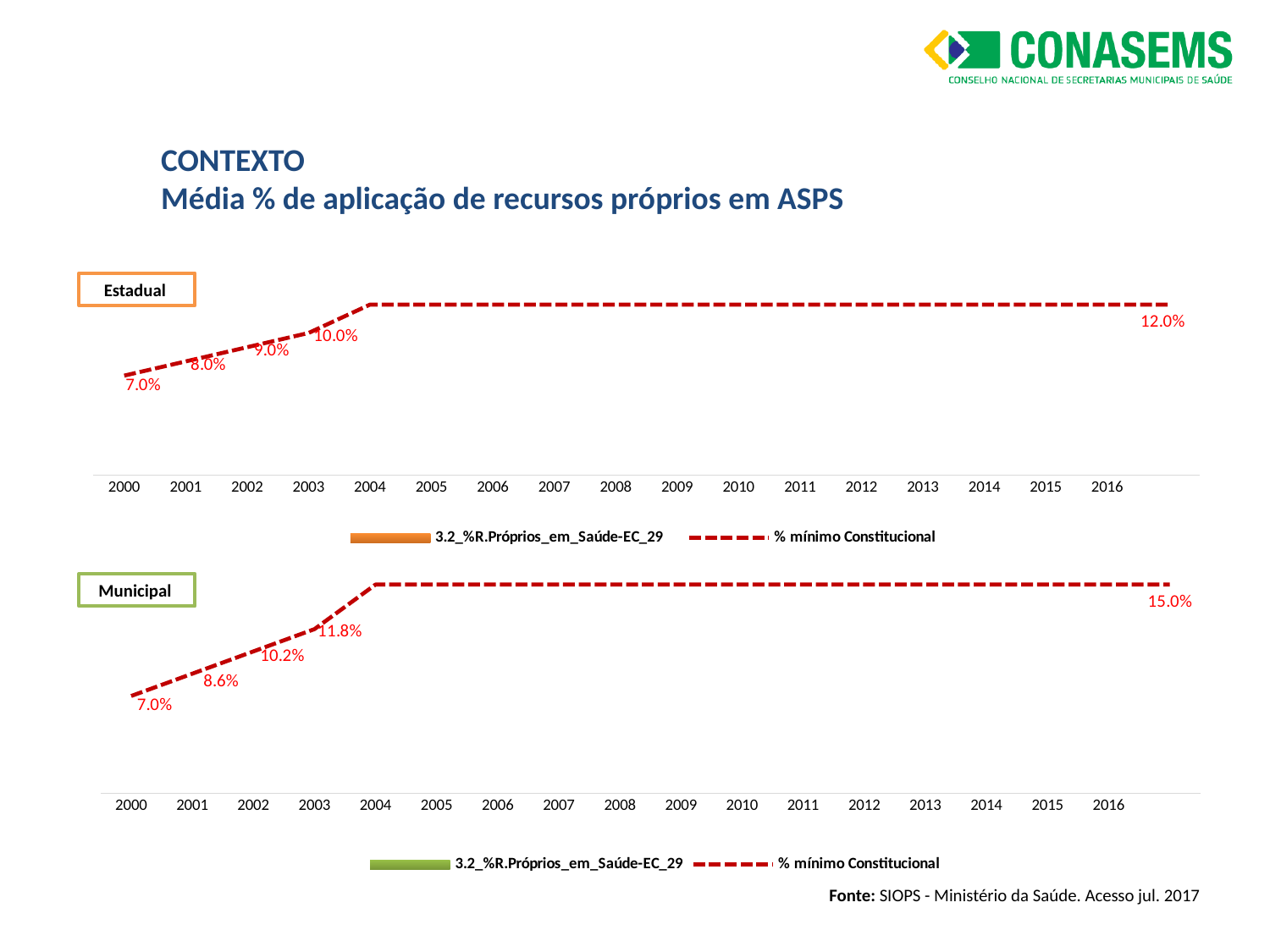
In the Estadual chart, what is the % mínimo Constitucional value labelled for 2000? 7.0% In the Municipal chart, what is the % mínimo Constitucional value labelled for 2001? 8.6% In the Municipal chart, what is the difference between the % mínimo Constitucional values labelled for 2002 and 2000? 3.2% Which chart shows the higher % mínimo Constitucional value at 2016, Estadual or Municipal? Municipal How many years are shown on the x axis of the Estadual chart? 17 How many series does the legend of the Municipal chart list? 2 In the Municipal chart, what is the % mínimo Constitucional value labelled for 2003? 11.8% In the Municipal chart, does the % mínimo Constitucional line rise or fall from 2000 to 2004? rise In the Estadual chart, what is the difference between the % mínimo Constitucional values labelled at 2016 and for 2000? 5.0% In the Estadual chart, what is the % mínimo Constitucional value labelled at 2016? 12.0% In the Estadual chart, what is the % mínimo Constitucional value labelled for 2003? 10.0% In the Municipal chart, what is the % mínimo Constitucional value labelled at 2016? 15.0%